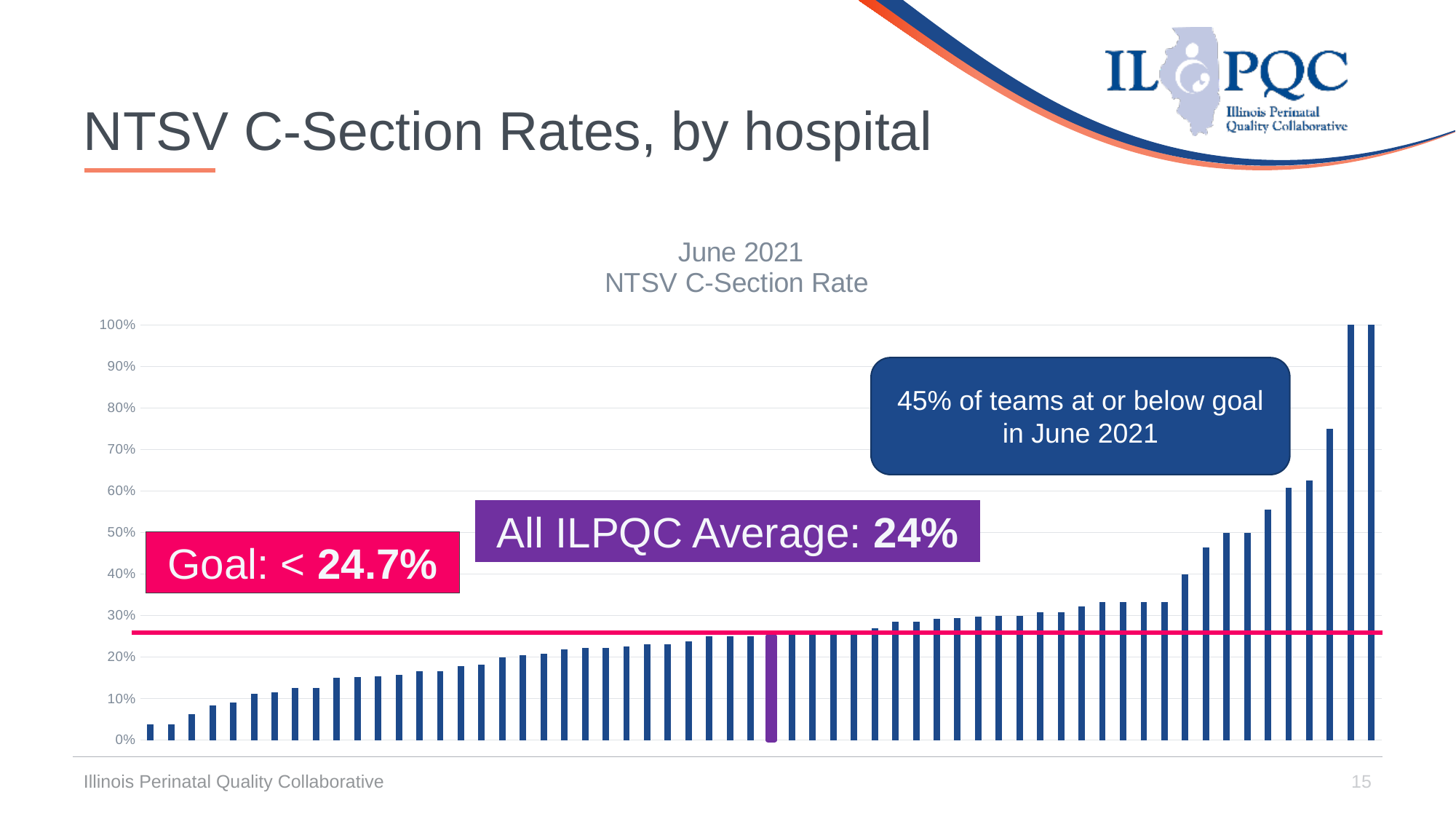
Is the value for the third bar from the right greater or less than 70%? greater According to the callout, what percentage of teams were at or below goal in June 2021? 45% Is the value for the purple bar greater or less than 30%? less What is the highest value shown on the y axis? 100% What is the All ILPQC Average shown on the chart? 24% Is the value for the leftmost bar greater or less than 10%? less What is the title of the chart? June 2021 NTSV C-Section Rate Which is larger, the rightmost bar or the leftmost bar? The rightmost bar What value do the two tallest bars on the right reach? 100% What goal is stated on the chart? < 24.7% Do the bar values rise or fall from left to right along the x axis? Rise What kind of chart is shown on the slide? Bar chart